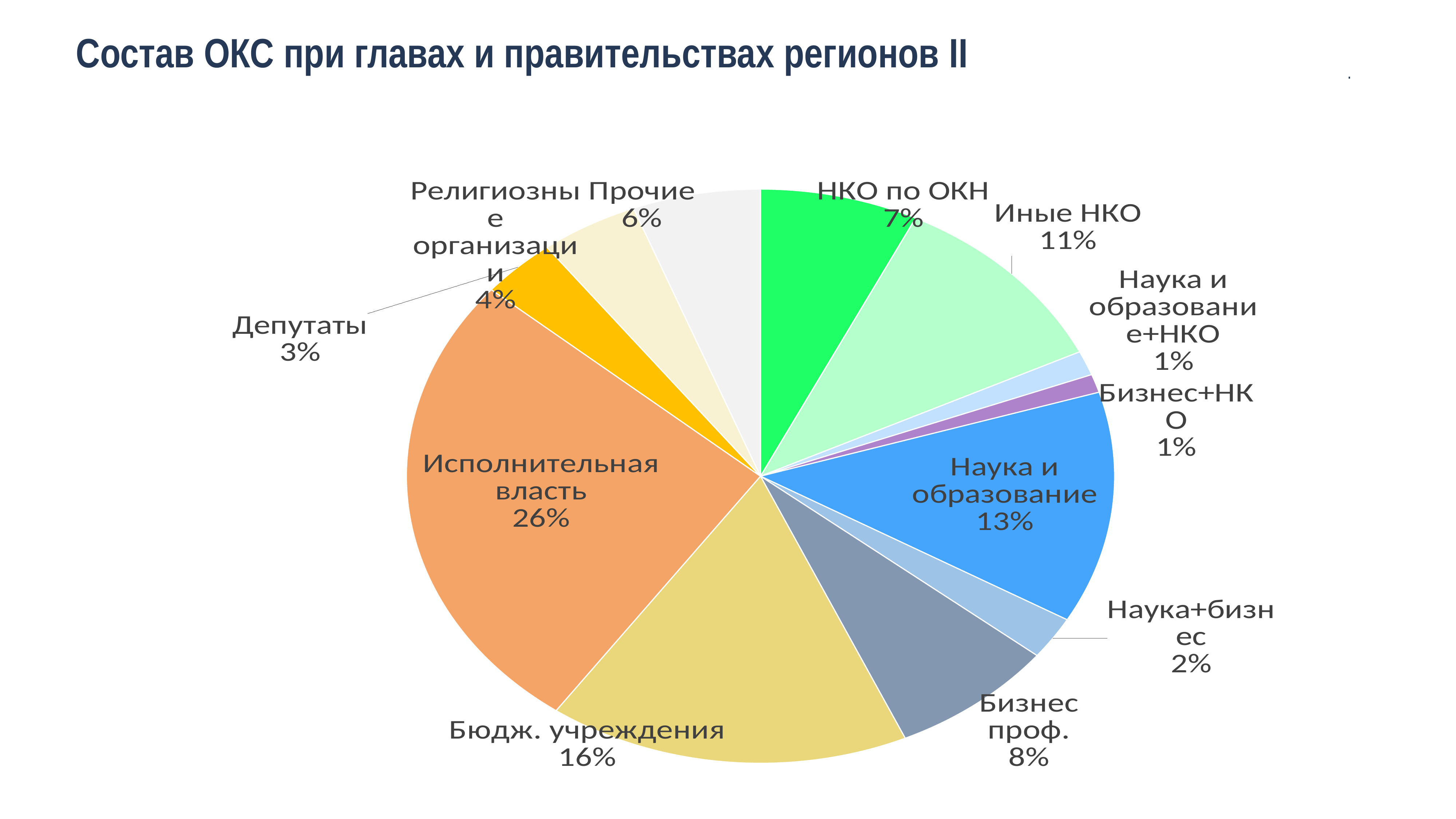
What is the title of the slide? Состав ОКС при главах и правительствах регионов II What share of the pie does Исполнительная власть have? 26% What is the value shown for Депутаты? 3% What is the value shown for Бюдж. учреждения? 16% What is the value shown for Бизнес проф.? 8% What kind of chart is shown on the slide? pie chart What is the value shown for Иные НКО? 11% What is the value shown for Наука и образование? 13% Which category has the largest share of the pie? Исполнительная власть What is the difference between the shares of Исполнительная власть and Бюдж. учреждения? 10% How many slices does the pie chart have? 12 Which is larger, the share of НКО по ОКН or the share of Прочие? НКО по ОКН